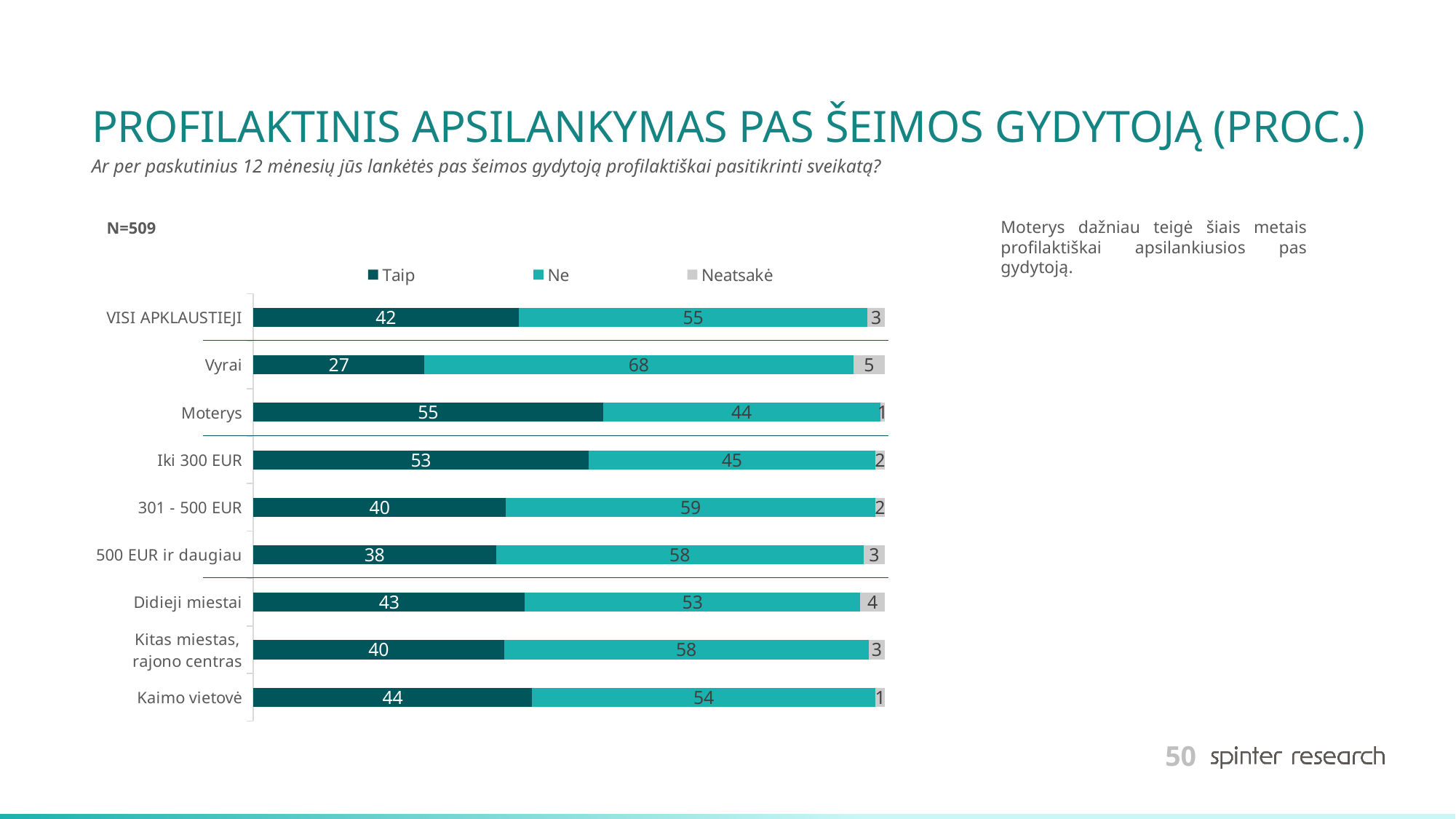
What kind of chart is shown on the slide? Stacked bar chart Which category has the highest 'Taip' value? Moterys What is the 'Ne' value for Vyrai? 68 What is the total of the stacked bar for Kaimo vietovė? 99 What sample size (N) is shown on the slide? N=509 What is the 'Taip' value for Moterys? 55 Which has a larger 'Ne' value, 301 - 500 EUR or Iki 300 EUR? 301 - 500 EUR How many categories are shown on the chart? 9 What is the 'Neatsakė' value for Didieji miestai? 4 How many series does the legend list? 3 Which category has the lowest 'Taip' value? Vyrai What is the difference between the 'Taip' values for Moterys and Vyrai? 28